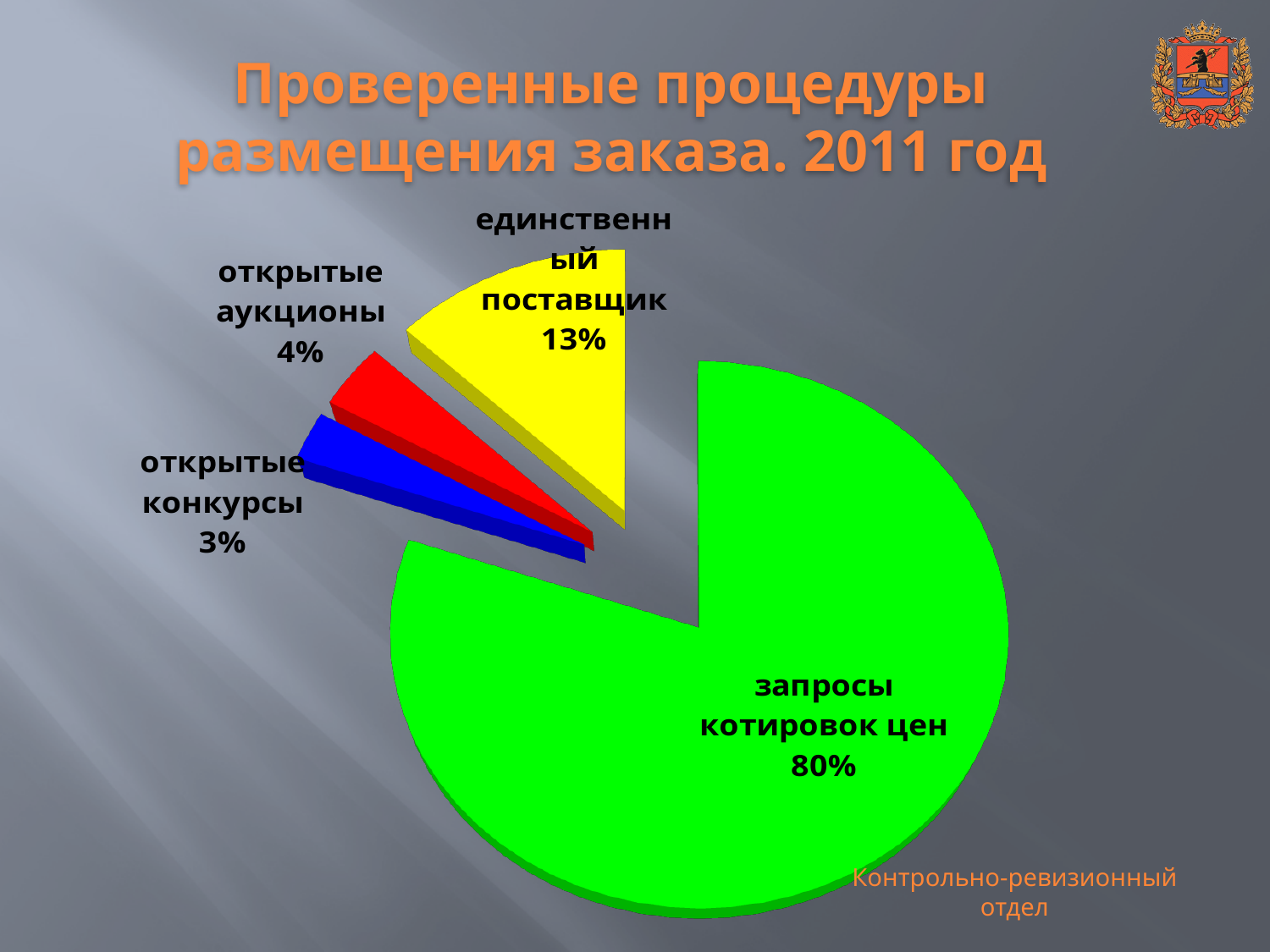
What share of the pie is labelled "открытые аукционы"? 4% Which is larger: the share for "открытые аукционы" or for "открытые конкурсы"? открытые аукционы What share of the pie is labelled "открытые конкурсы"? 3% What kind of chart is shown on the slide? pie chart Which category has the largest slice of the pie? запросы котировок цен What share of the pie is labelled "единственный поставщик"? 13% What is the difference in percentage points between "запросы котировок цен" and "единственный поставщик"? 67 What colour is the slice for "единственный поставщик"? yellow What is the title of the slide? Проверенные процедуры размещения заказа. 2011 год What share of the pie is labelled "запросы котировок цен"? 80% How many slices does the pie chart have? 4 Which category has the smallest slice of the pie? открытые конкурсы